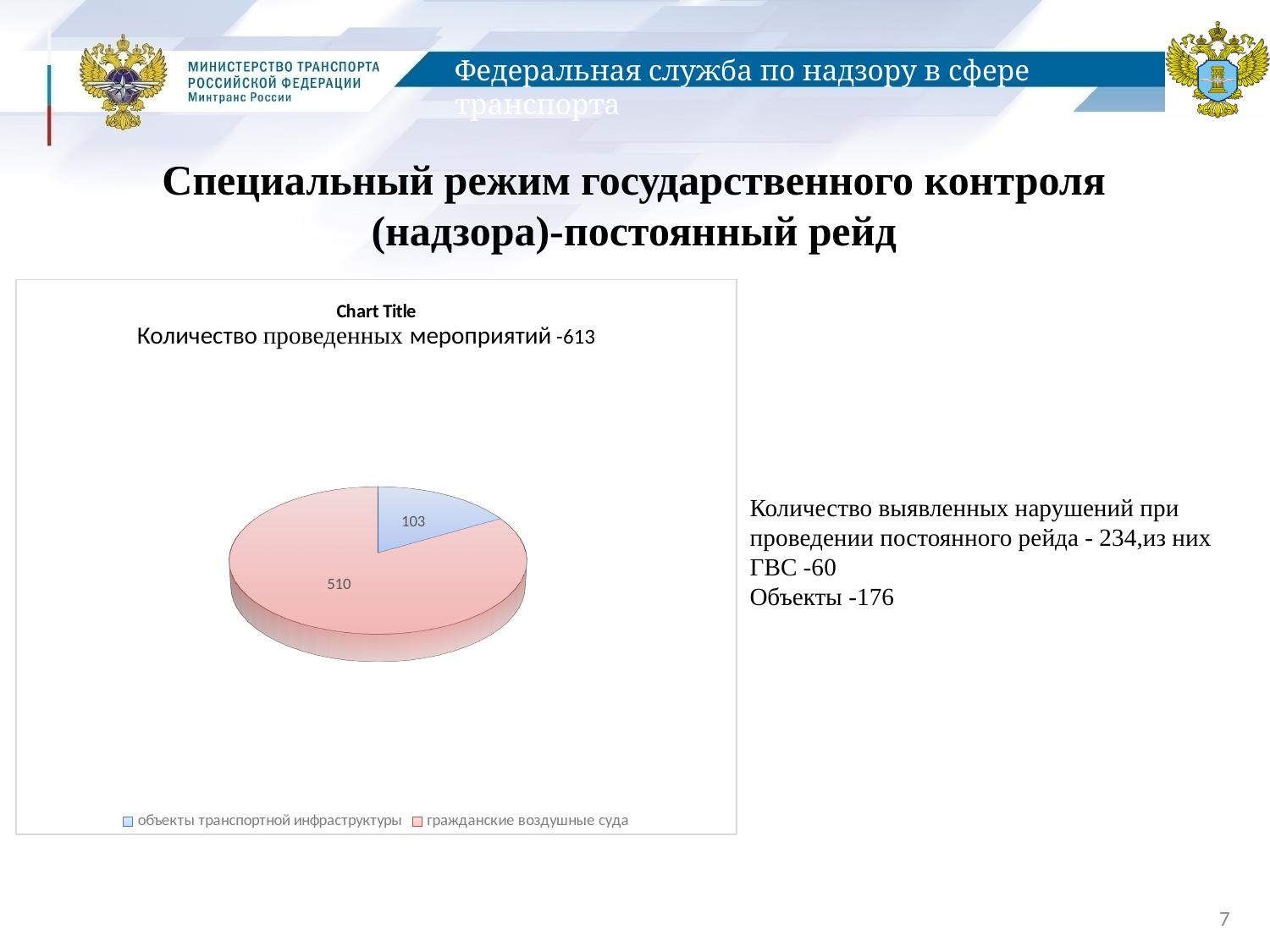
What share of the pie does the гражданские воздушные суда slice represent? 83.2% What kind of chart is shown on the slide? pie chart How many slices does the pie chart have? 2 What is the value for гражданские воздушные суда in the pie chart? 510 How many entries does the legend of the pie chart list? 2 What colour is the slice for объекты транспортной инфраструктуры in the pie chart? blue What is the total of the two slices in the pie chart? 613 Which category has the smallest slice in the pie chart? объекты транспортной инфраструктуры Which is larger: the value for объекты транспортной инфраструктуры or the value for гражданские воздушные суда? гражданские воздушные суда Which category has the largest slice in the pie chart? гражданские воздушные суда What is the value for объекты транспортной инфраструктуры in the pie chart? 103 What is the difference between the values for гражданские воздушные суда and объекты транспортной инфраструктуры? 407